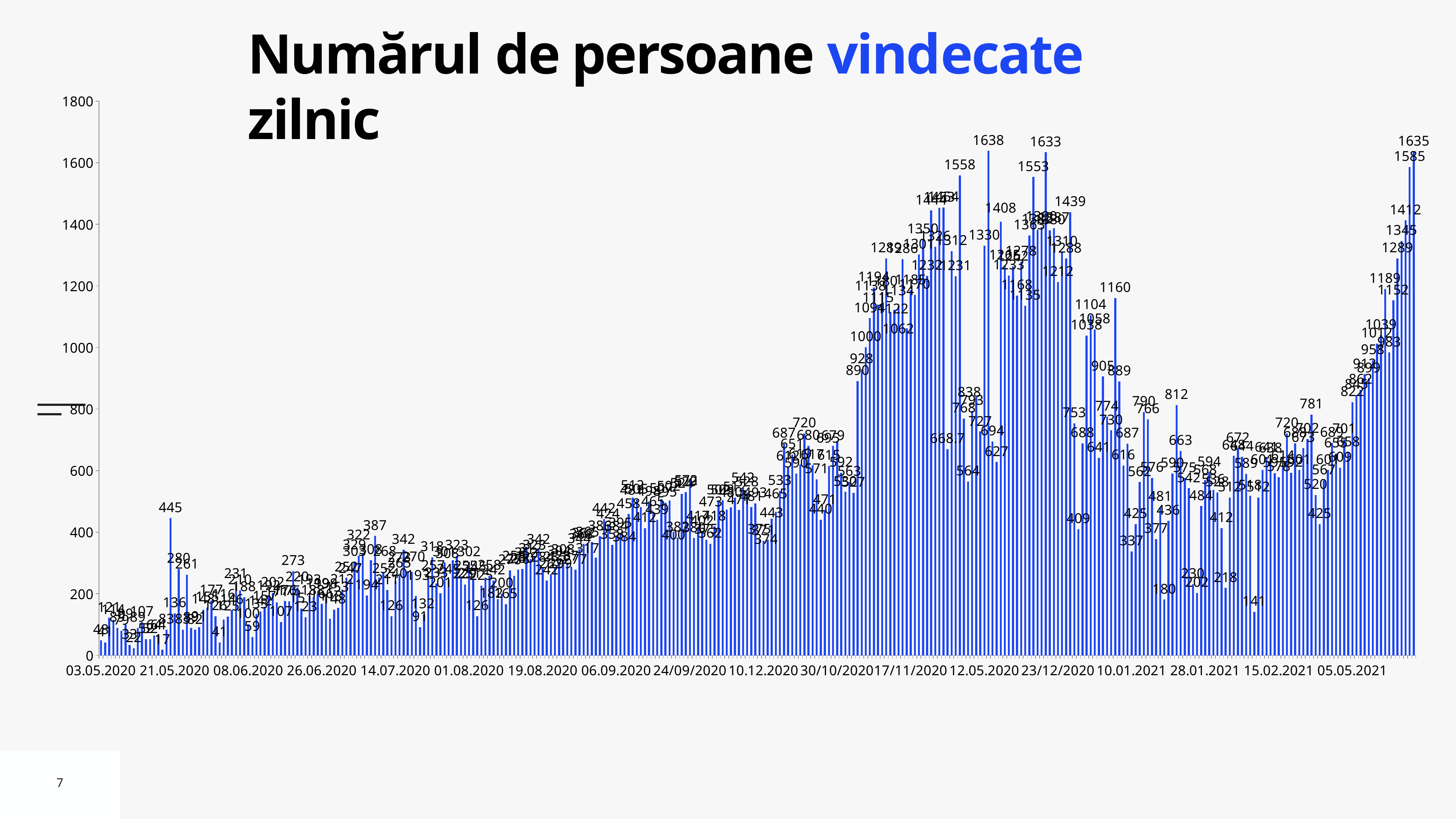
Which is larger: the bar labelled 445 near 21.05.2020 or the bar labelled 387 near 14.07.2020? 445 What is the highest value shown on the vertical axis? 1800 Is the value of the bar labelled 337 near 10.01.2021 greater or less than 400? less What kind of chart is shown on the slide? bar chart Is the value of the rightmost bar greater or less than 1600? greater Overall, do the values rise or fall from the left end of the x axis to the right end? rise What value is printed on the rightmost (last) bar of the chart? 1635 What is the title of the chart? Numărul de persoane vindecate zilnic What value is printed on the tall isolated bar shortly after the 21.05.2020 axis label? 445 What is the difference between the bars labelled 1635 and 1585 at the right end of the chart? 50 What value is printed on the tallest bar near the 23/12/2020 axis label? 1633 What value is printed on the peak bar just before the 14.07.2020 axis label? 387